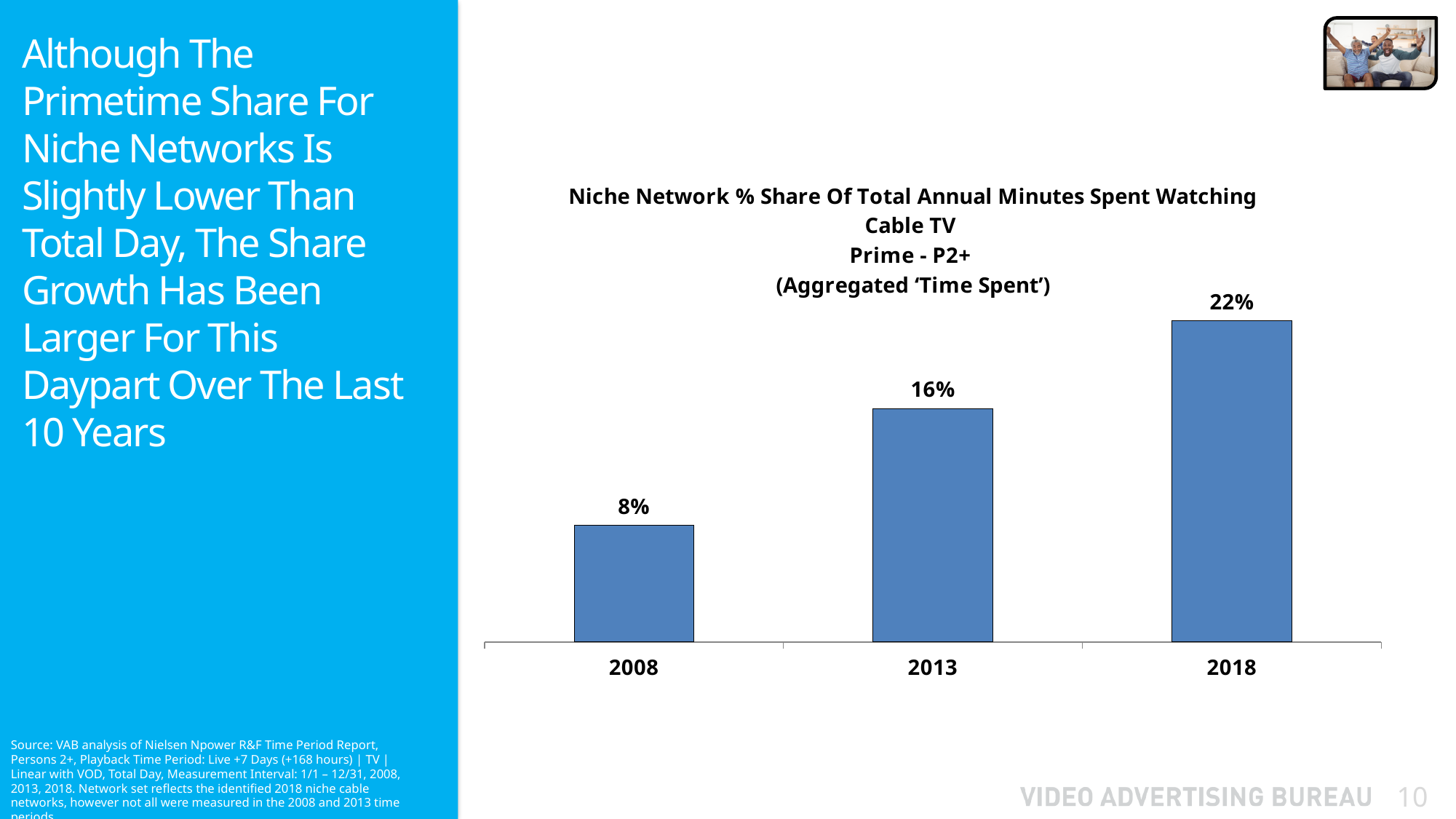
How many years are shown on the chart? 3 Which year has the highest niche network share? 2018 What is the difference in niche network share between 2018 and 2008? 14% Which year has a larger niche network share, 2013 or 2018? 2018 Which year has the lowest niche network share? 2008 Does the niche network share rise or fall from 2008 to 2018? Rise What is the niche network share of total annual minutes spent watching cable TV in prime for 2018? 22% What audience demographic is named in the chart title? P2+ What is the difference in niche network share between 2013 and 2008? 8% What is the niche network share of total annual minutes spent watching cable TV in prime for 2008? 8% What is the niche network share of total annual minutes spent watching cable TV in prime for 2013? 16% What kind of chart is shown on the slide? Bar chart